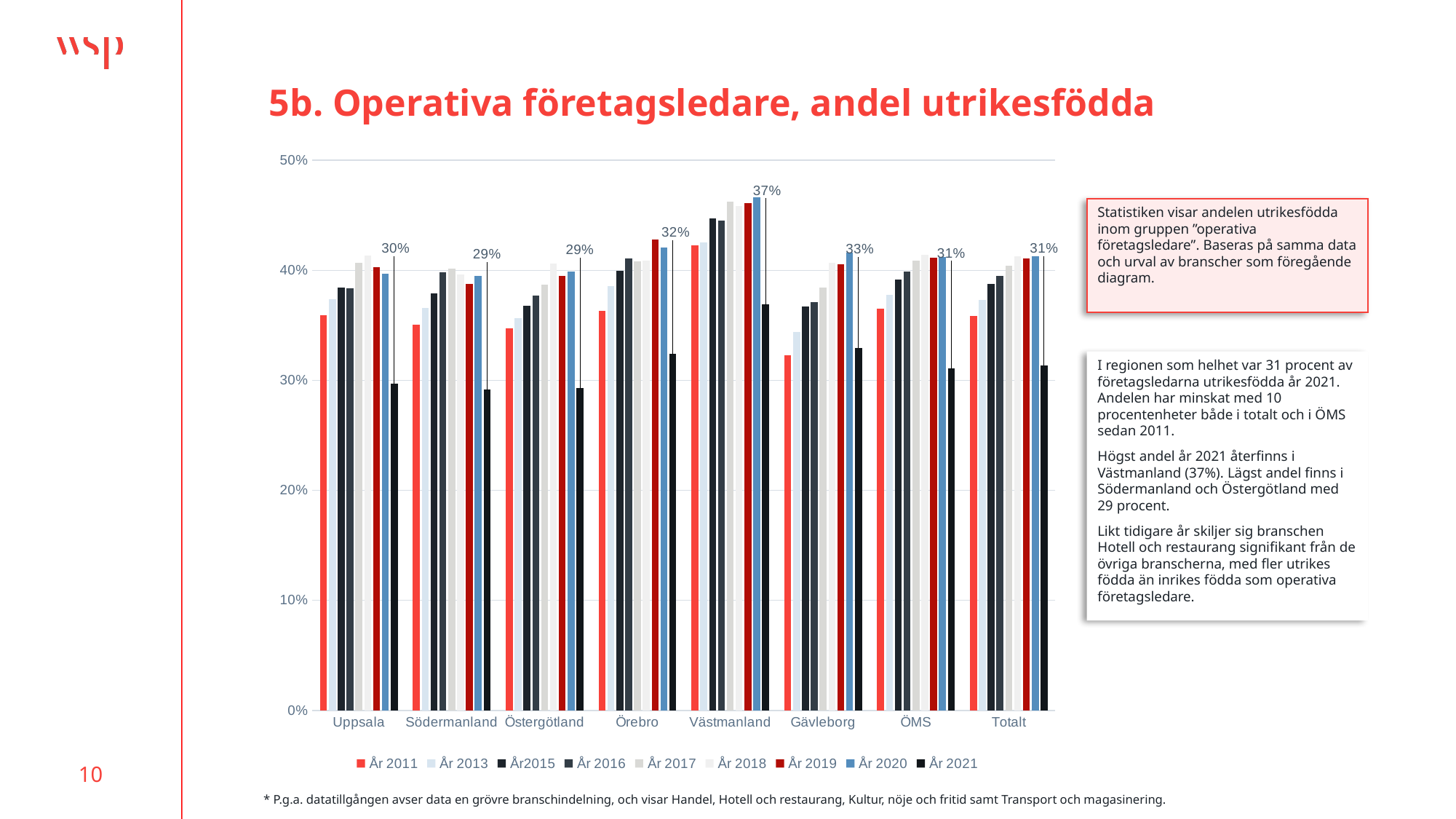
Which two regions share the lowest value for År 2021? Södermanland and Östergötland How many regions/categories are shown on the x axis? 8 What kind of chart is shown on the slide? Bar chart How many series does the legend list? 9 Is the value for År 2019 in Västmanland greater or less than 40%? greater Is the value for År 2011 in Uppsala greater or less than 30%? greater What is the value for År 2021 in Västmanland? 37% What is the value for År 2021 for ÖMS? 31% What is the difference between the År 2021 values for Västmanland and Uppsala? 7 percentage points What is the value for År 2021 in Uppsala? 30% Which is larger for År 2021: Gävleborg or Örebro? Gävleborg Which region has the highest value for År 2021? Västmanland